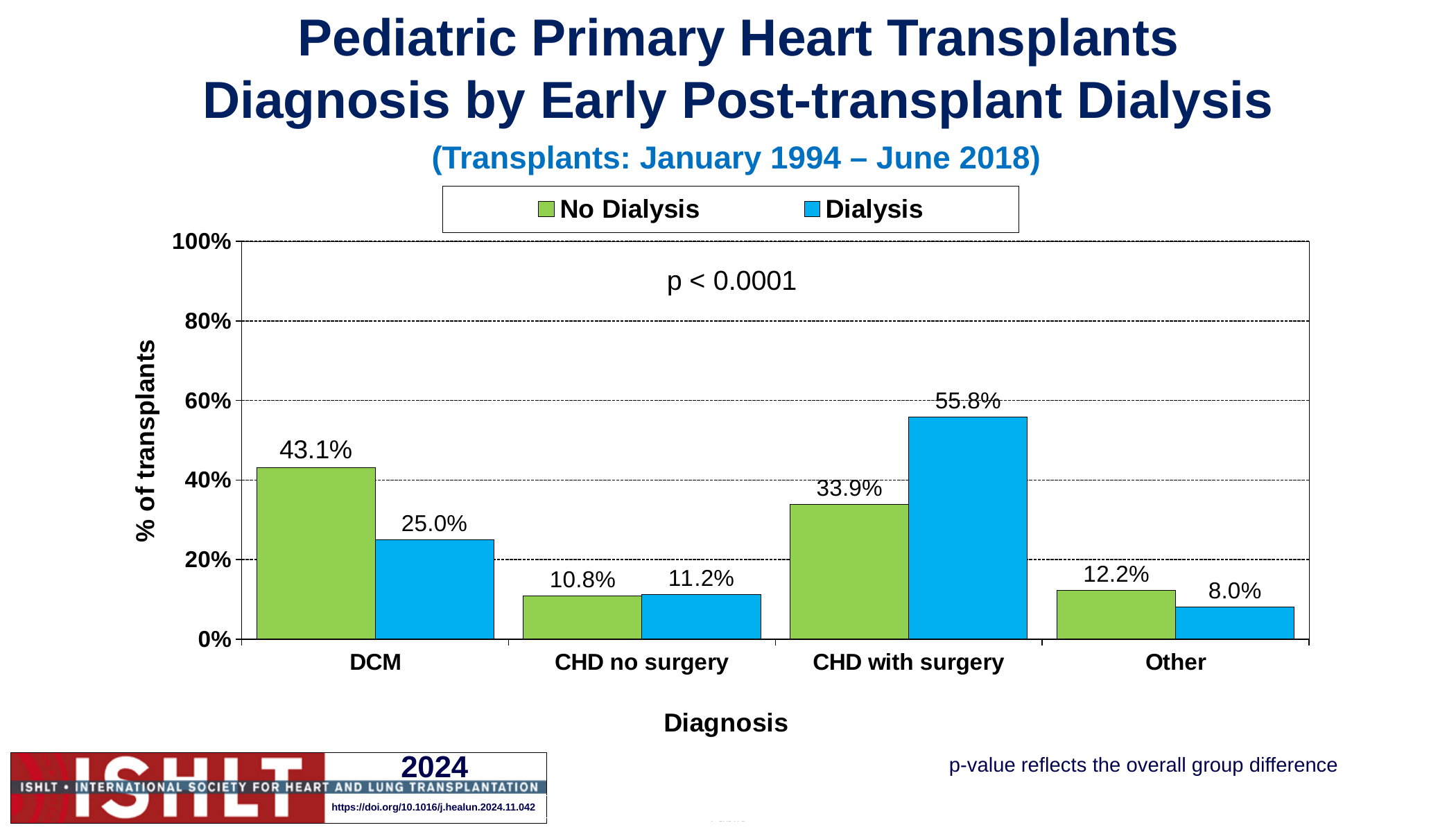
Is the No Dialysis value for CHD with surgery greater or less than 40%? less What is the No Dialysis value for DCM? 43.1% What is the difference between the No Dialysis and Dialysis values for DCM? 18.1% What is the Dialysis value for Other? 8.0% How many series does the legend list? 2 What p-value is printed on the chart? p < 0.0001 Which diagnosis has the highest Dialysis value? CHD with surgery Which diagnosis has the lowest No Dialysis value? CHD no surgery For CHD with surgery, which series has the larger value, No Dialysis or Dialysis? Dialysis What kind of chart is shown on the slide? bar chart What is the Dialysis value for CHD with surgery? 55.8% How many diagnosis categories are shown on the x axis? 4